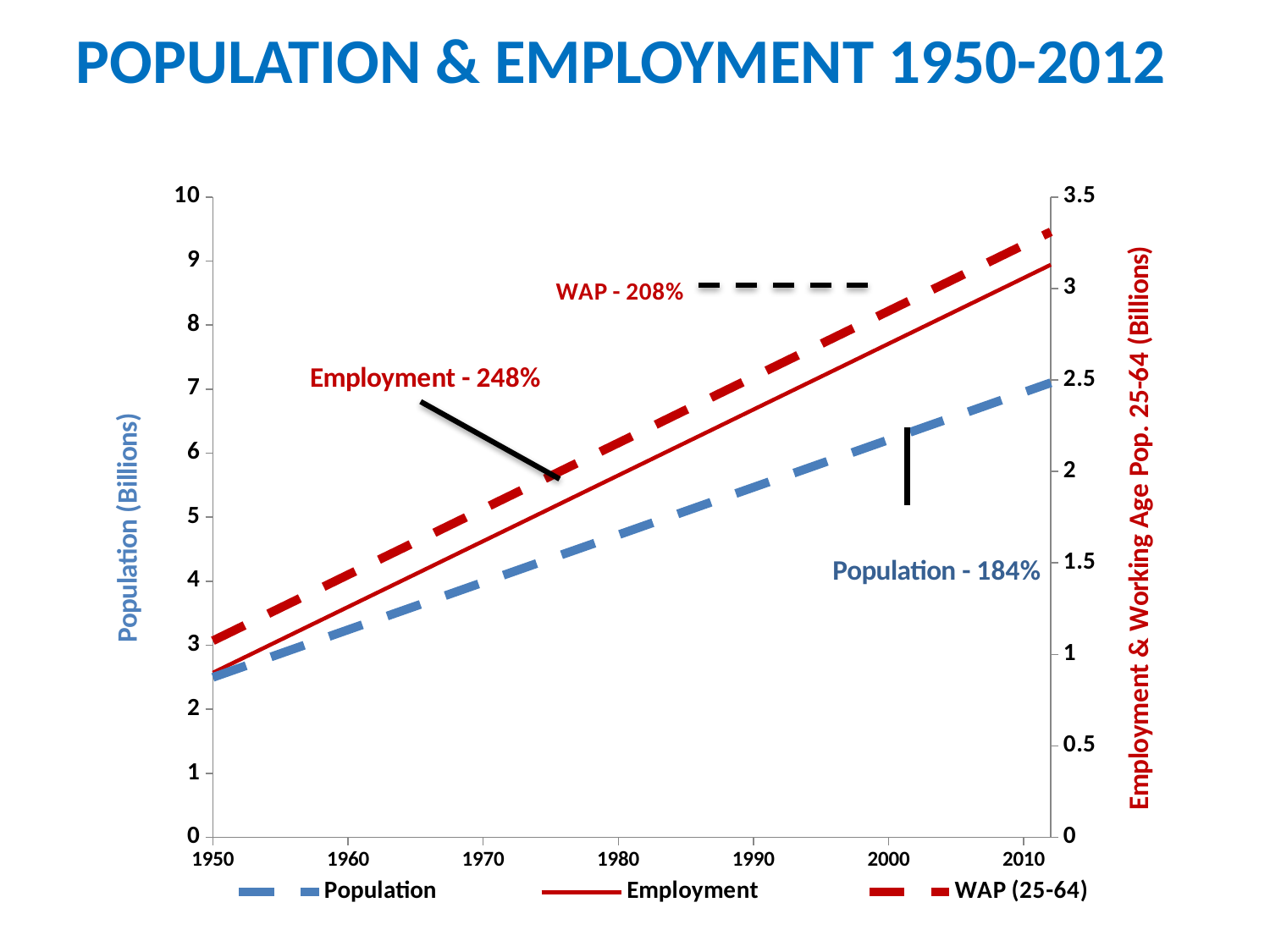
Is the Population value in 1950 greater or less than 3 billion on the left axis? less What growth percentage is annotated for Employment? 248% Which series has the lowest annotated growth percentage? Population Does the Population line rise or fall from 1950 to 2012? rise What growth percentage is annotated for Population? 184% What is the difference between the annotated growth percentages for Employment and Population? 64 percentage points What growth percentage is annotated for WAP? 208% What kind of chart is shown on the slide? line chart Is the Population value in 2010 greater or less than 6 billion on the left axis? greater How many series does the legend list? 3 Which series has the highest annotated growth percentage? Employment In 2010, which is higher on the right axis: WAP (25-64) or Employment? WAP (25-64)